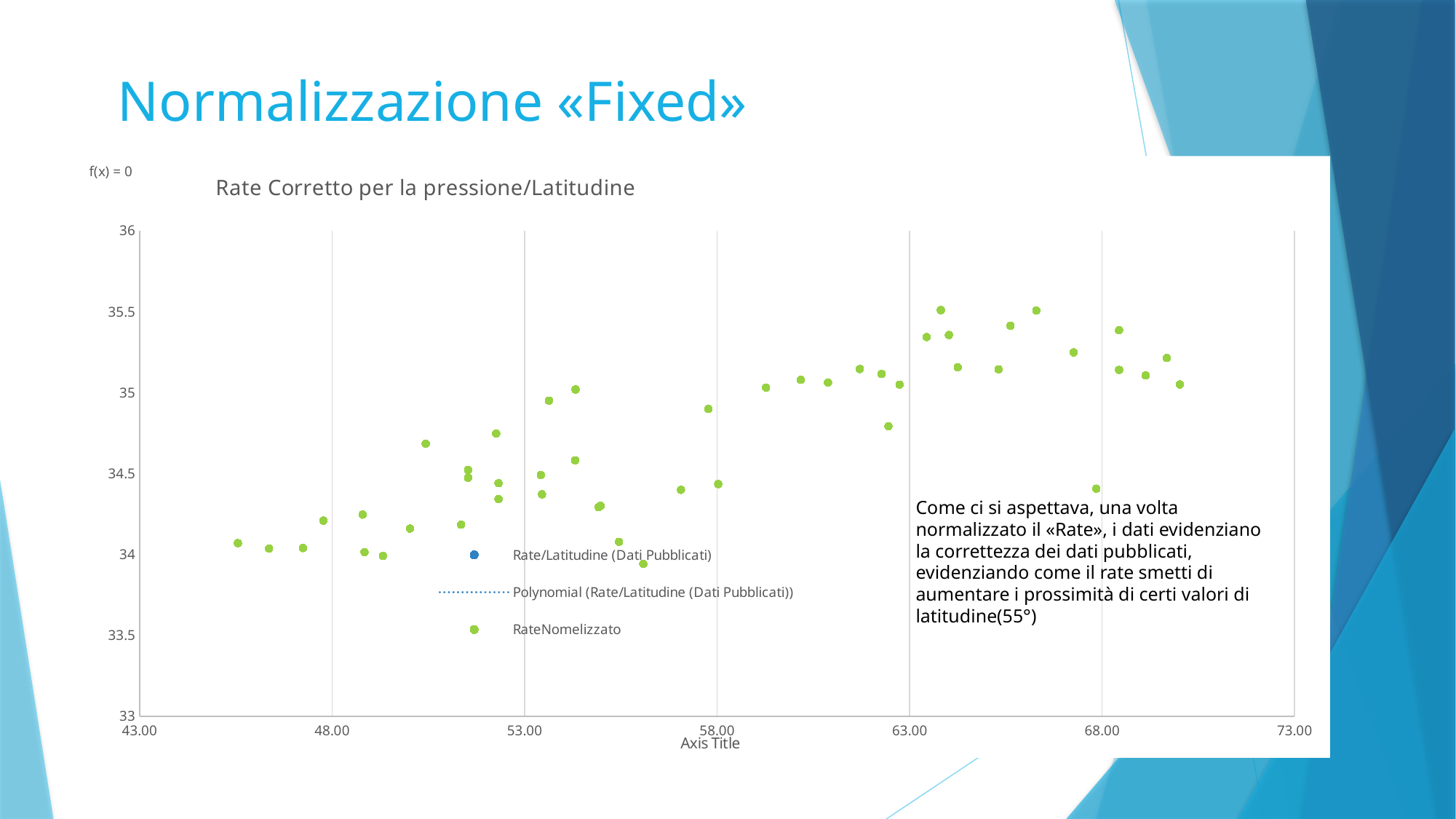
Do the plotted RateNomelizzato values generally rise or fall as the x-axis value increases? rise Is the isolated point plotted just below x = 68.00 greater or less than 35? less What is the largest tick value shown on the horizontal axis? 73.00 What is the title of the chart? Rate Corretto per la pressione/Latitudine Are any of the plotted points greater than 36 on the vertical axis? no Are the plotted points near x = 63.00 to 68.00 mostly greater or less than 35 on the vertical axis? greater What is the label shown on the horizontal axis of the chart? Axis Title What kind of chart is shown on the slide? scatter chart What is the highest value shown on the vertical axis of the chart? 36 What is the smallest tick value shown on the horizontal axis? 43.00 What is the lowest value shown on the vertical axis of the chart? 33 How many series does the chart legend list? 3